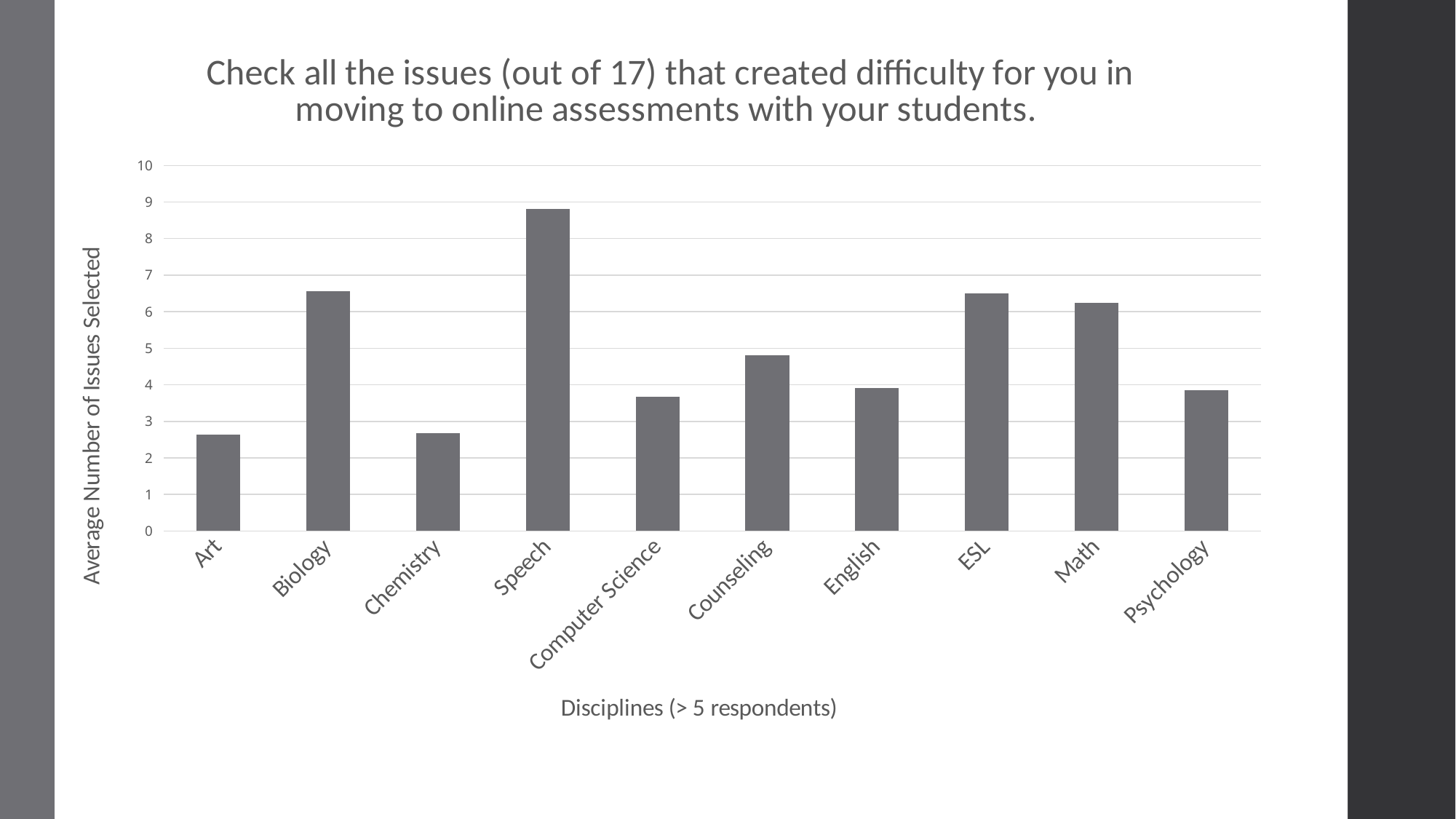
What kind of chart is shown on the slide? bar chart Which discipline has the highest average number of issues selected? Speech How many disciplines are shown on the x axis of the chart? 10 Is the value for Speech greater or less than 8? greater Which has a higher average number of issues selected, Speech or Biology? Speech Is the value for Art greater or less than 3? less Is the value for Counseling greater or less than 5? less Which has a higher average number of issues selected, Counseling or English? Counseling What is the label of the y axis of the chart? Average Number of Issues Selected